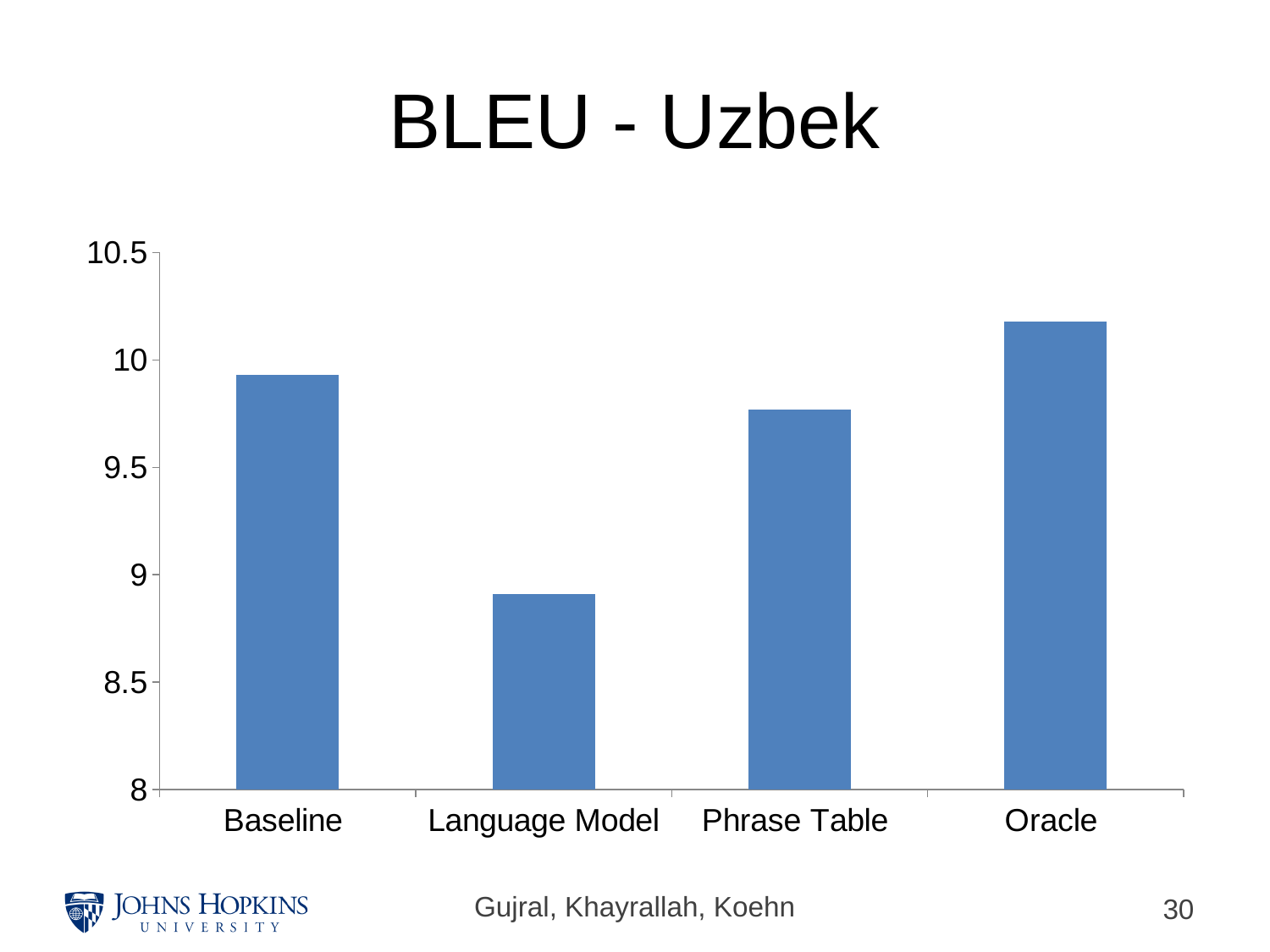
Is the value for Baseline greater or less than 9.5? greater What is the title of the chart? BLEU - Uzbek Is the value for Language Model greater or less than 9? less Is the value for Oracle greater or less than 10? greater Which category has the highest BLEU score? Oracle Which category has the lowest BLEU score? Language Model How many categories are shown on the x axis of the chart? 4 Which is higher, the value for Baseline or the value for Oracle? Oracle What kind of chart is shown on the slide? bar chart What is the lowest value shown on the y axis of the chart? 8 Which is higher, the value for Baseline or the value for Phrase Table? Baseline